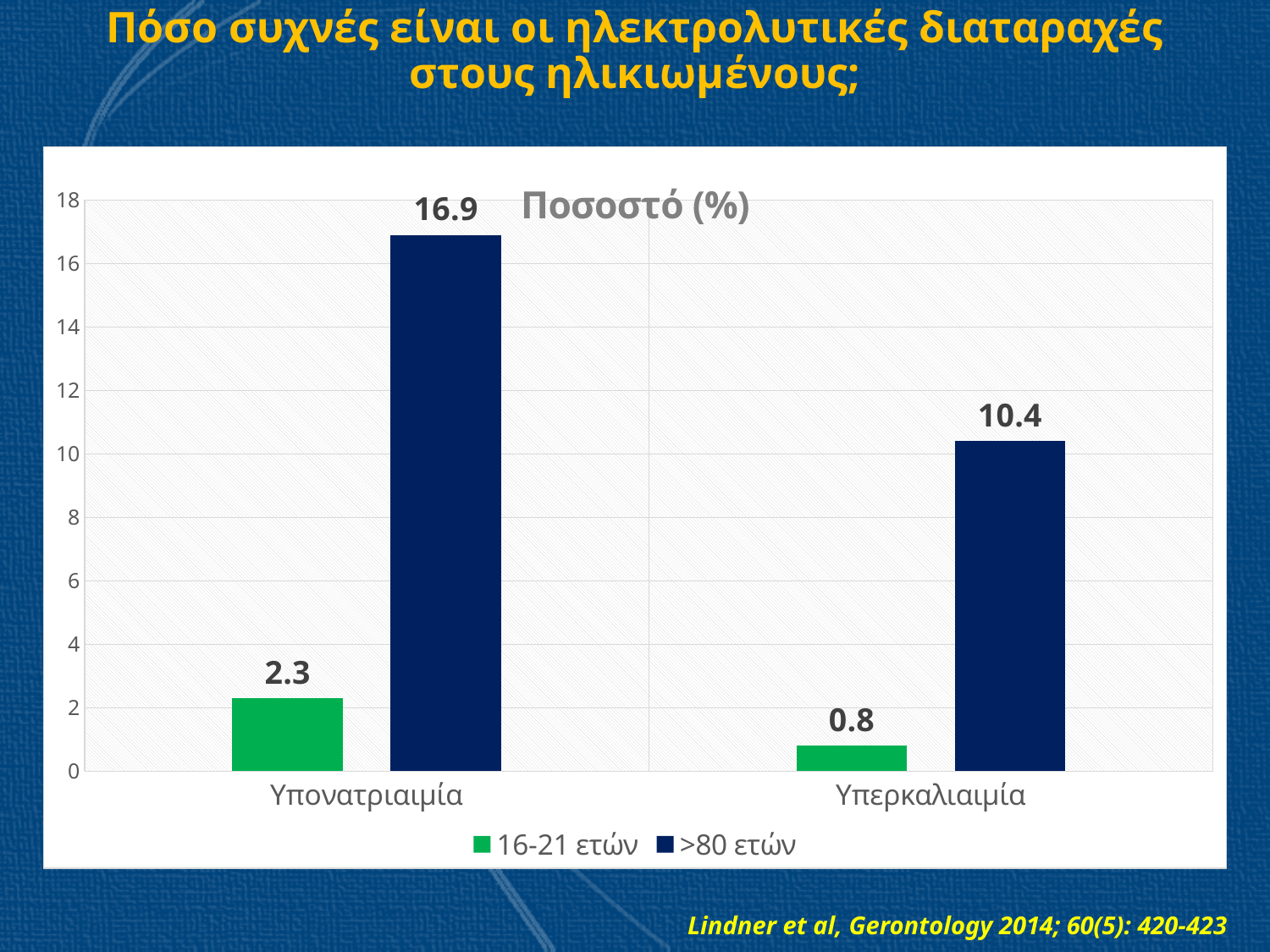
How many categories are shown on the x axis? 2 Which is larger for Υπερκαλιαιμία: the 16-21 ετών value or the >80 ετών value? >80 ετών What is the value for Υπονατριαιμία in the >80 ετών series? 16.9 What is the difference between the >80 ετών and 16-21 ετών values for Υπονατριαιμία? 14.6 Which category has the highest value in the >80 ετών series? Υπονατριαιμία How many series does the legend list? 2 Which category has the lowest value in the 16-21 ετών series? Υπερκαλιαιμία What is the value for Υπερκαλιαιμία in the >80 ετών series? 10.4 What kind of chart is shown on the slide? Bar chart What is the difference between the >80 ετών values for Υπονατριαιμία and Υπερκαλιαιμία? 6.5 What is the value for Υπερκαλιαιμία in the 16-21 ετών series? 0.8 What is the value for Υπονατριαιμία in the 16-21 ετών series? 2.3